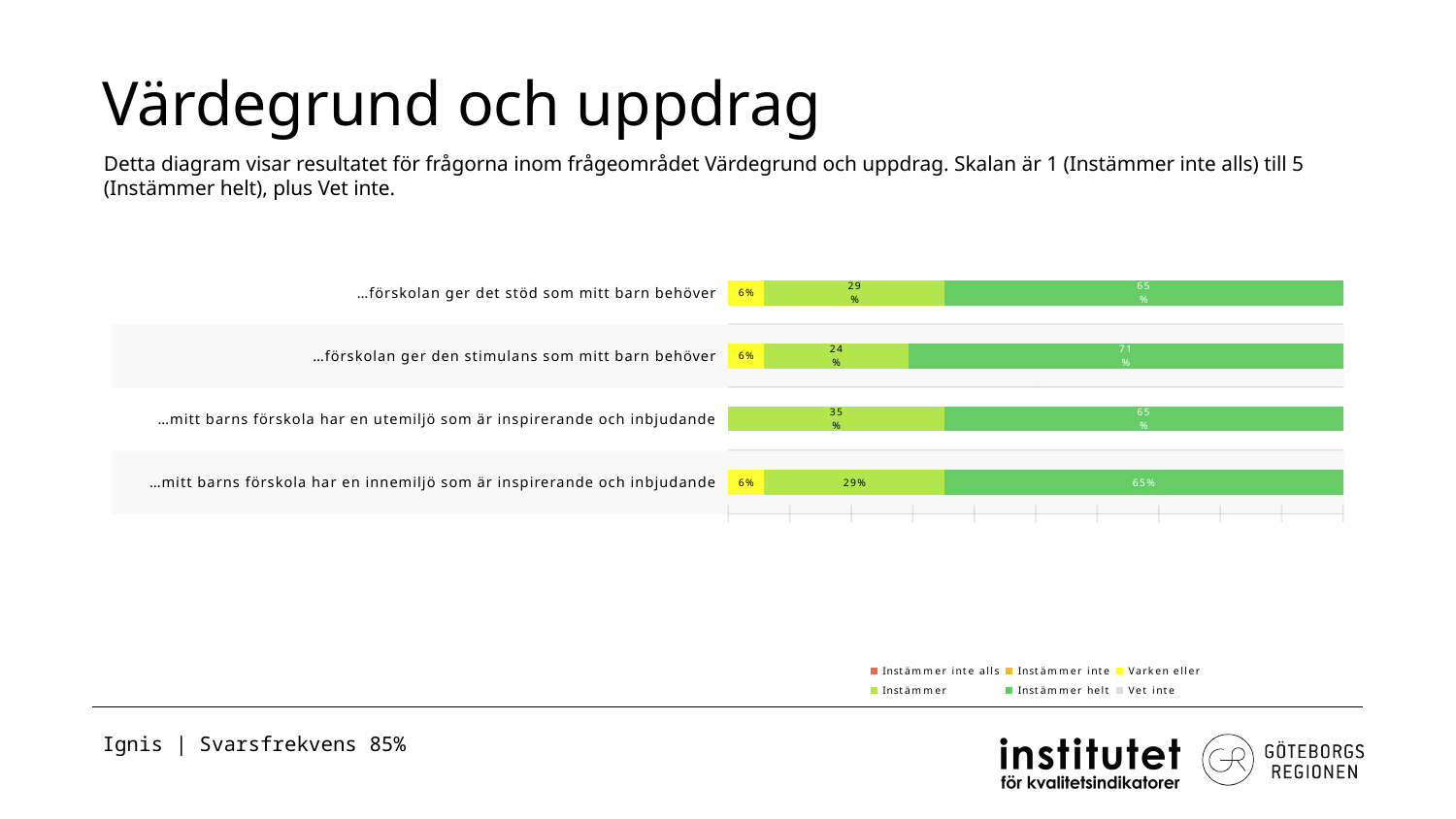
What is the 'Instämmer helt' value for '…mitt barns förskola har en innemiljö som är inspirerande och inbjudande'? 65% Which is larger: the 'Instämmer' value for '…mitt barns förskola har en utemiljö som är inspirerande och inbjudande' or for '…förskolan ger den stimulans som mitt barn behöver'? …mitt barns förskola har en utemiljö som är inspirerande och inbjudande What is the 'Instämmer' value for '…mitt barns förskola har en utemiljö som är inspirerande och inbjudande'? 35% How many categories (questions) are plotted in the chart? 4 Which category has the highest 'Instämmer helt' value? …förskolan ger den stimulans som mitt barn behöver What is the difference between the 'Instämmer helt' values for '…förskolan ger den stimulans som mitt barn behöver' and '…förskolan ger det stöd som mitt barn behöver'? 6% What is the 'Instämmer helt' value for '…förskolan ger den stimulans som mitt barn behöver'? 71% What kind of chart is shown on the slide? Stacked bar chart What is the 'Varken eller' value for '…förskolan ger det stöd som mitt barn behöver'? 6% Which category has the lowest 'Instämmer' value? …förskolan ger den stimulans som mitt barn behöver How many series does the legend list? 6 What is the title of the slide containing the chart? Värdegrund och uppdrag